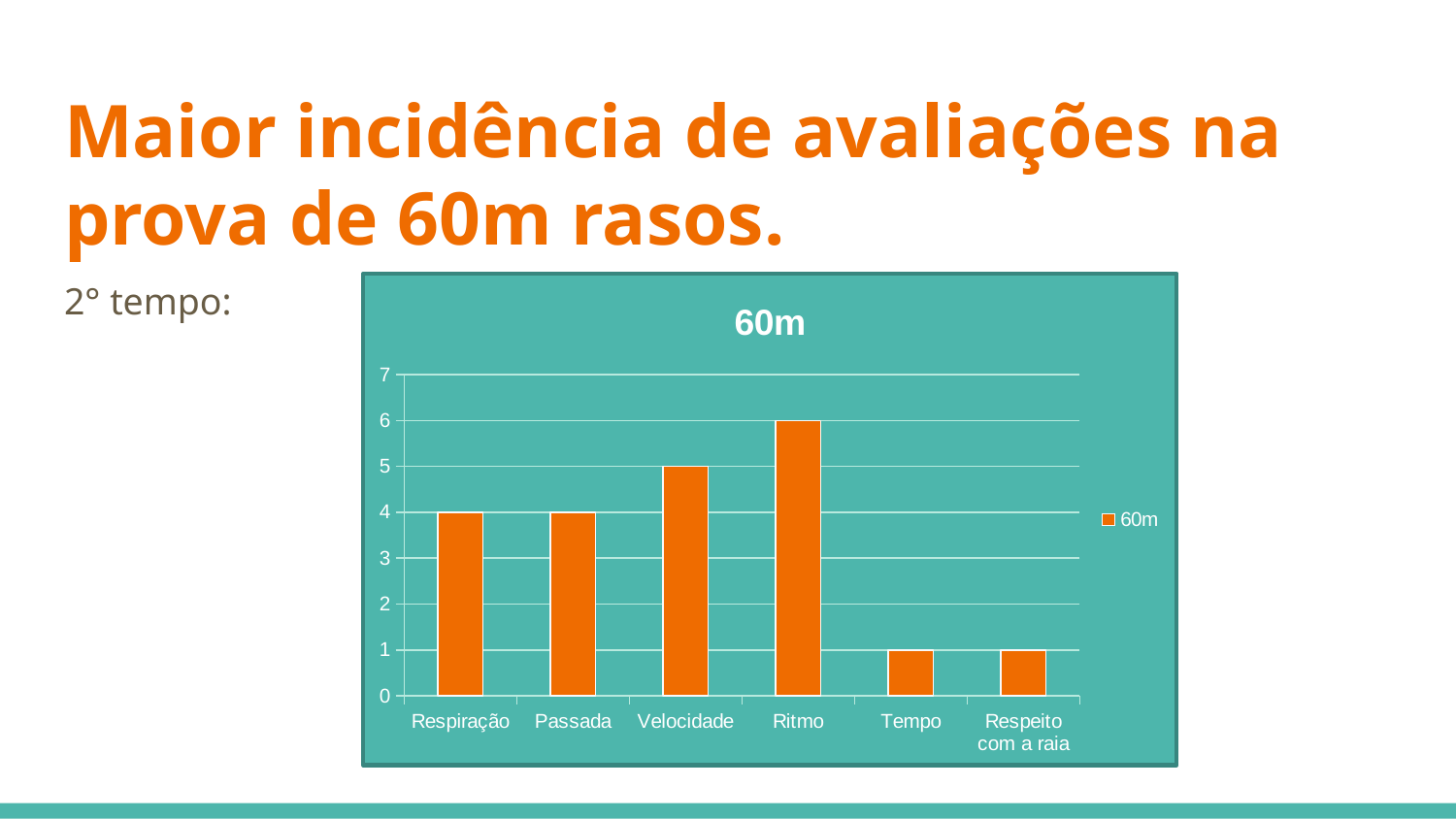
Which category has the highest value? Ritmo What is the value for Velocidade? 5 How many categories are shown on the x axis? 6 What kind of chart is shown? bar chart What is the difference between the values for Respiração and Tempo? 3 Which is larger, the value for Velocidade or the value for Passada? Velocidade How many series does the legend list? 1 Is the value for Respiração greater or less than 3? greater What is the difference between the values for Ritmo and Velocidade? 1 What is the value for Tempo? 1 What is the value for Ritmo? 6 What is the title of the chart? 60m